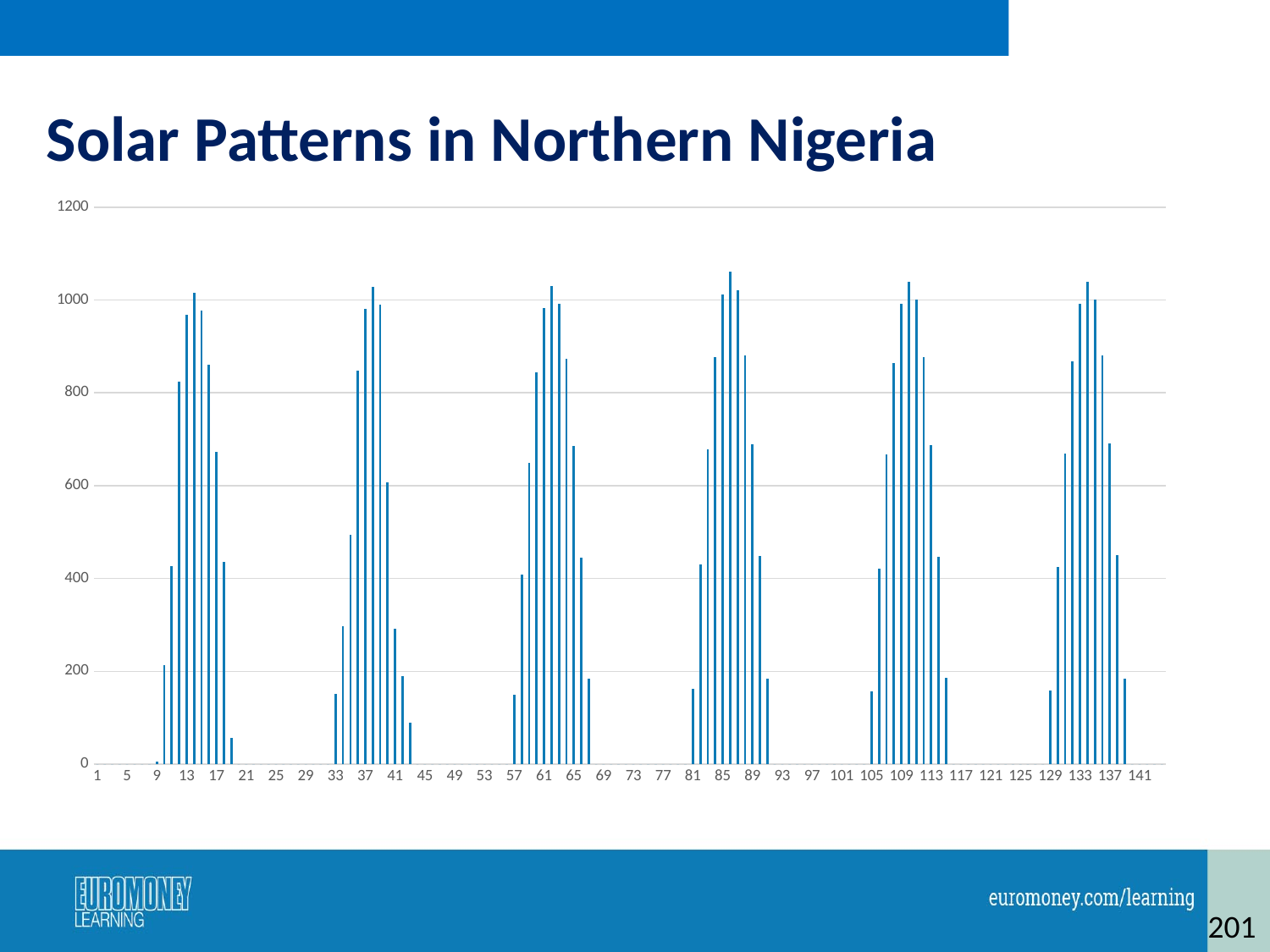
What is the title of the chart? Solar Patterns in Northern Nigeria What is the highest value shown on the y axis? 1200 Is the tallest bar in the chart greater or less than 1200? less Is the tallest bar in the chart greater or less than 1000? greater Do the bar values rise steadily along the x axis, or do they follow a repeating pattern of peaks and gaps? repeating pattern of peaks and gaps What kind of chart is shown on the slide? bar chart Is the tallest bar in the cluster around x = 37 greater or less than 800? greater Are there any bars plotted between x = 21 and x = 29? No What is the last label shown on the x axis? 141 How many separate clusters (peaks) of bars appear across the chart? 6